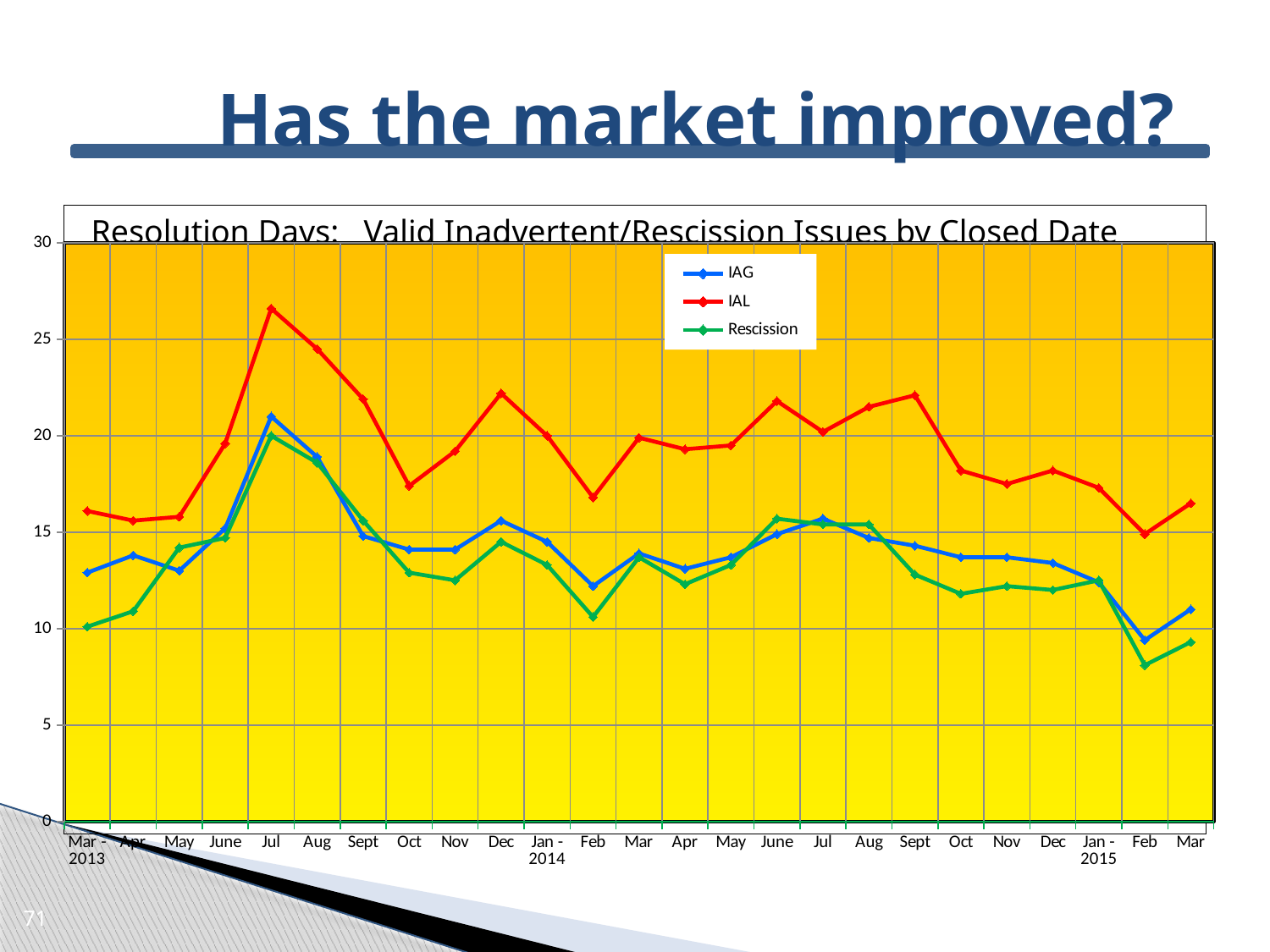
In which month does the Rescission series reach its lowest value? Feb 2015 What is the title of the chart? Resolution Days: Valid Inadvertent/Rescission Issues by Closed Date Is the IAL value for Jul 2013 greater or less than 25? greater Which series is larger in Jul 2013, IAL or IAG? IAL In which month does the IAL series reach its highest value? Jul 2013 Is the Rescission value for Feb 2015 greater or less than 10? less What are the three series named in the legend? IAG, IAL, Rescission What kind of chart is shown on the slide? line chart Does the IAL series rise or fall from Jul 2013 to Oct 2013? fall How many months are plotted along the x axis? 25 In which month does the IAG series reach its lowest value? Feb 2015 How many series does the legend list? 3